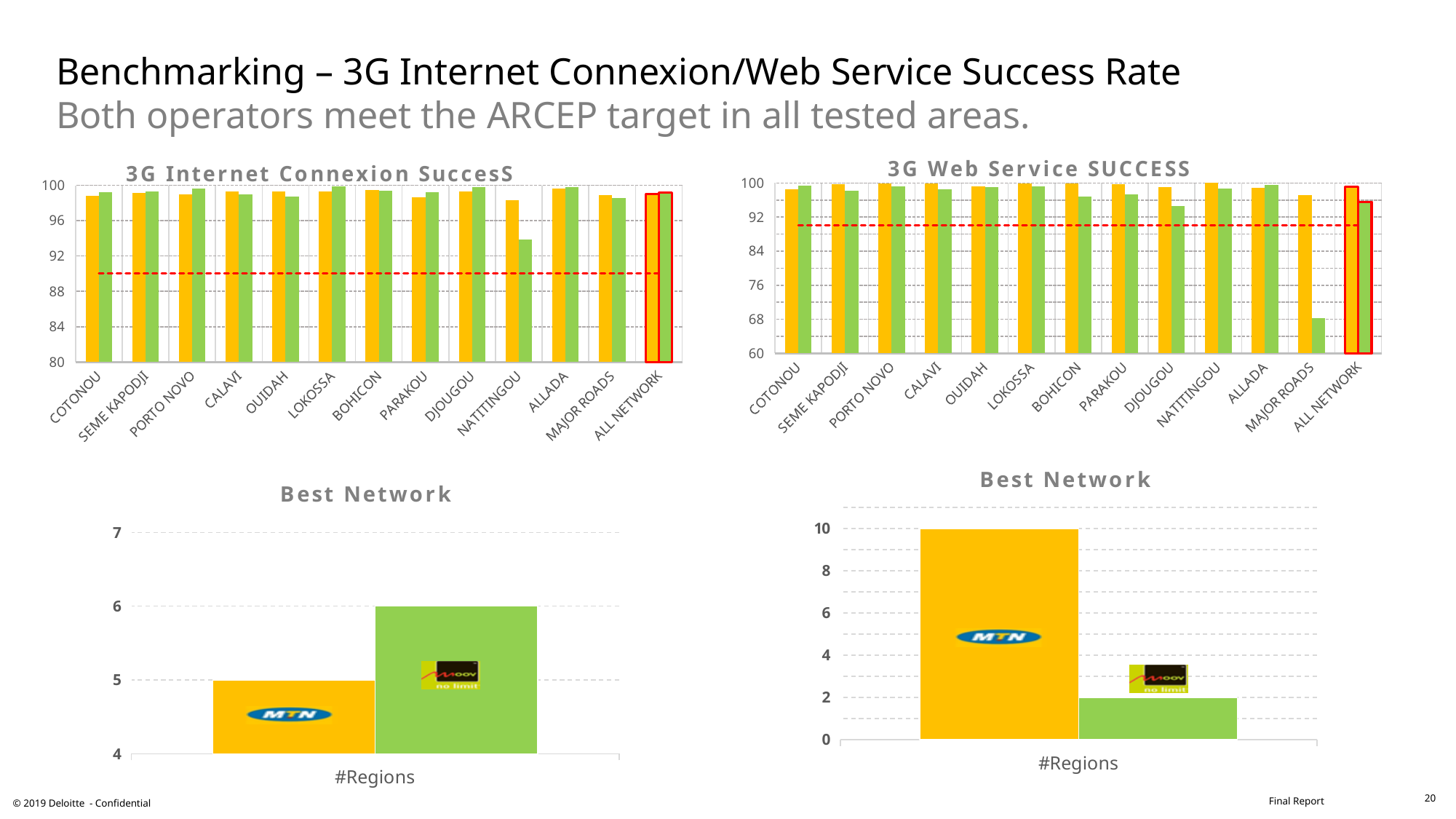
In the bottom-left 'Best Network' chart, which operator has the larger bar, MTN or Moov? Moov In the bottom-right 'Best Network' chart, what is the value of the MTN bar? 10 In the bottom-left 'Best Network' chart, what is the value of the MTN bar? 5 In the bottom-left 'Best Network' chart, what is the value of the Moov bar? 6 In the '3G Web Service SUCCESS' chart, is the green bar for MAJOR ROADS greater or less than 76? less In the '3G Web Service SUCCESS' chart, which category has the lowest green bar? MAJOR ROADS In the '3G Internet Connexion SuccesS' chart, is the orange bar for COTONOU greater or less than 96? greater How many categories are shown on the x axis of the '3G Internet Connexion SuccesS' chart? 13 What kind of chart is the '3G Internet Connexion SuccesS' chart at the top left? bar chart In the bottom-right 'Best Network' chart, what is the difference between the MTN bar and the Moov bar? 8 How many categories are shown on the x axis of the '3G Web Service SUCCESS' chart? 13 In the '3G Internet Connexion SuccesS' chart, is the green bar for NATITINGOU greater or less than 96? less